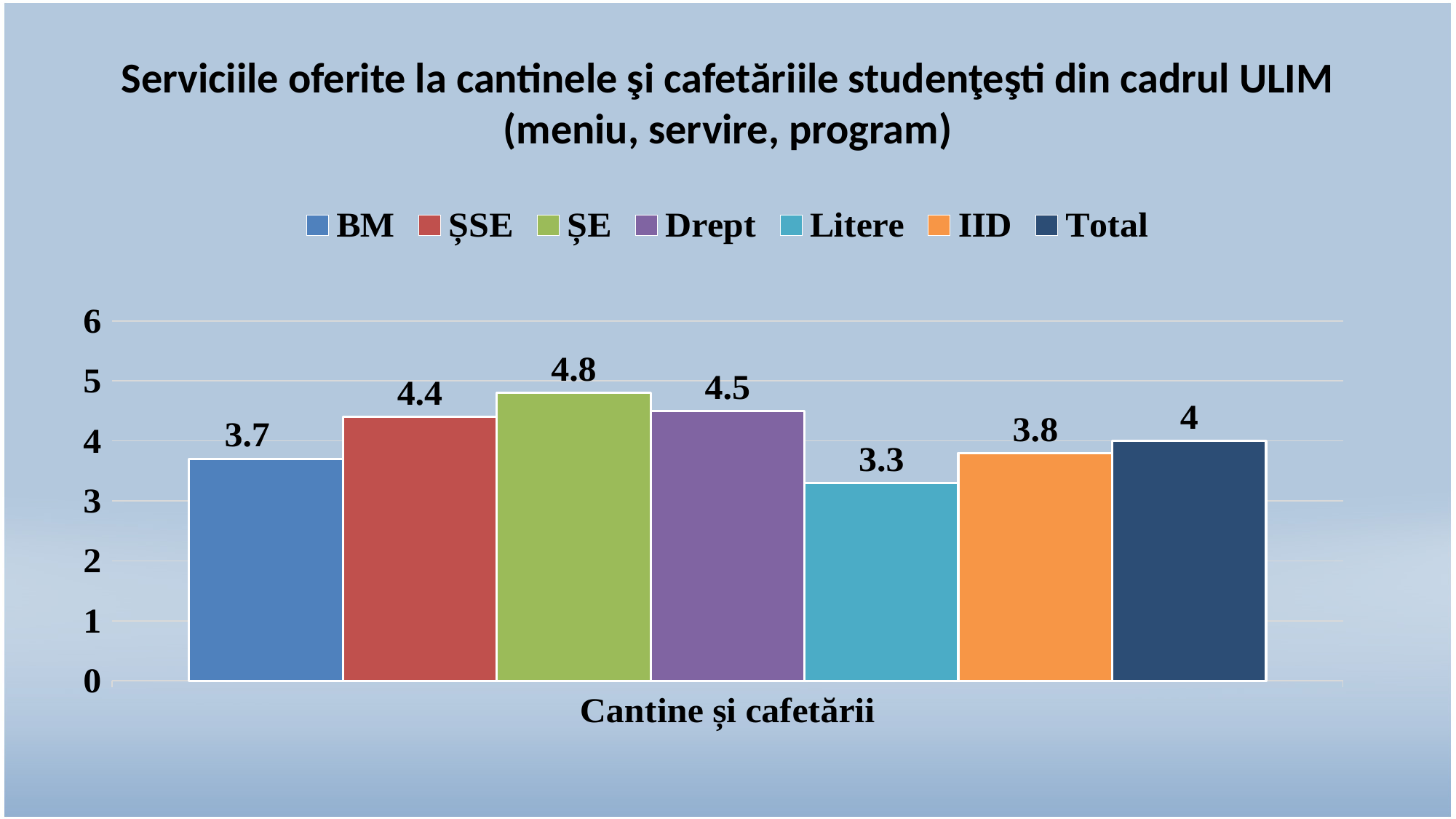
Which series has the lowest value? Litere How many series does the legend list? 7 Which series has the highest value? ȘE What is the label on the x axis of the chart? Cantine și cafetării What kind of chart is shown on the slide? bar chart What is the difference between the values for Drept and BM? 0.8 What is the difference between the values for ȘE and Litere? 1.5 What is the value for ȘE? 4.8 What is the value for Total? 4 What is the value for Litere? 3.3 Which is larger, the value for ȘSE or the value for IID? ȘSE Is the value for BM greater or less than 4? less